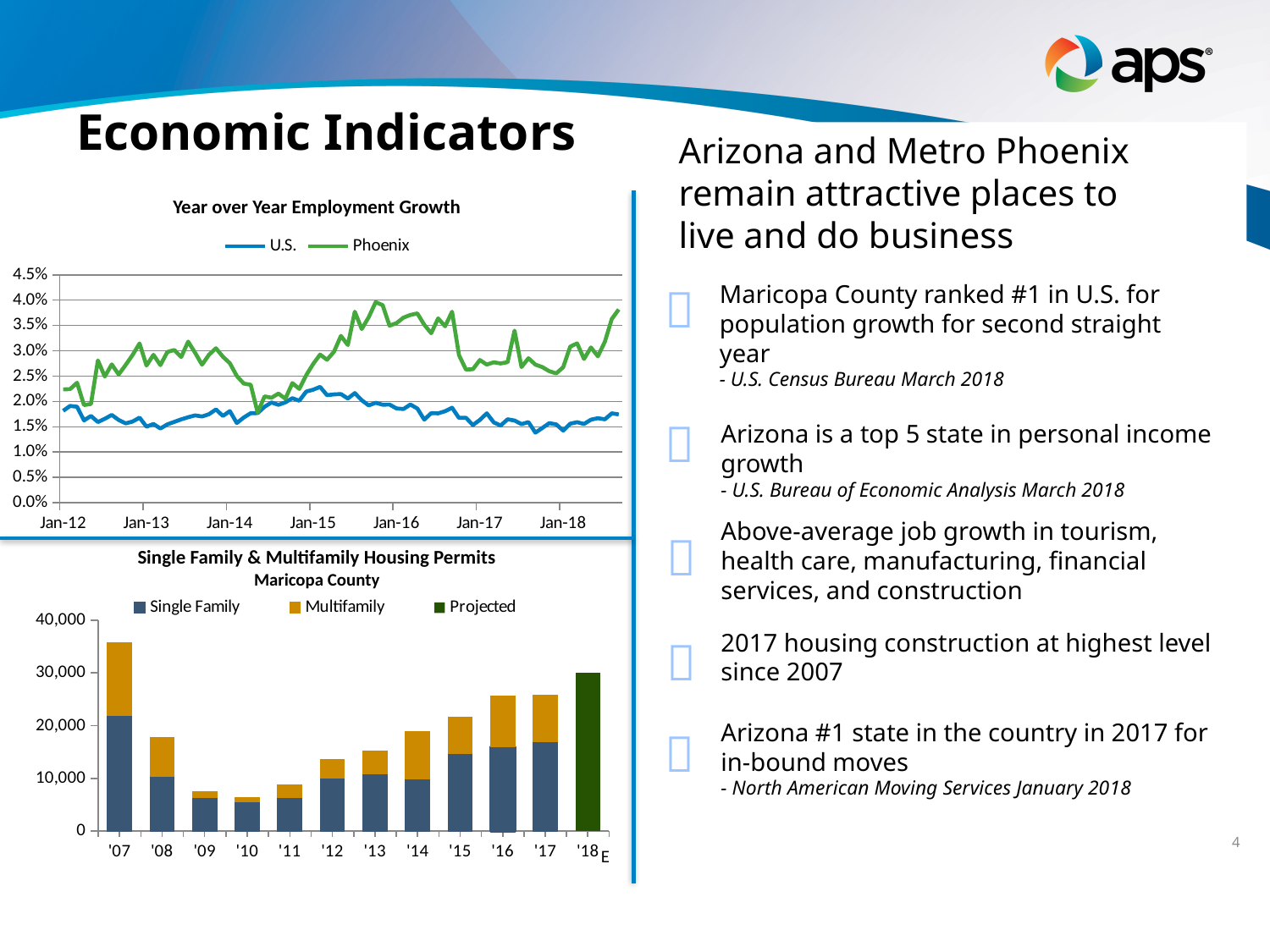
What kind of chart is the 'Year over Year Employment Growth' chart? line chart How many series does the legend of the 'Single Family & Multifamily Housing Permits' chart list? 3 In the 'Year over Year Employment Growth' chart, is the Phoenix value at Jan-16 greater or less than 3.0%? greater In the 'Single Family & Multifamily Housing Permits' chart, do total permits rise or fall from '10 to '17? rise What kind of chart is the 'Single Family & Multifamily Housing Permits' chart? bar chart In the 'Single Family & Multifamily Housing Permits' chart, which year has the lowest total permits? '10 How many series does the legend of the 'Year over Year Employment Growth' chart list? 2 In the 'Year over Year Employment Growth' chart, is the U.S. value at Jan-18 greater or less than 2.0%? less In the 'Single Family & Multifamily Housing Permits' chart, which year has the highest total permits? '07 In the 'Single Family & Multifamily Housing Permits' chart, is the projected value for '18E greater or less than 20,000? greater How many years are shown on the x axis of the 'Single Family & Multifamily Housing Permits' chart? 12 In the 'Year over Year Employment Growth' chart, which series is generally higher over the period shown, U.S. or Phoenix? Phoenix